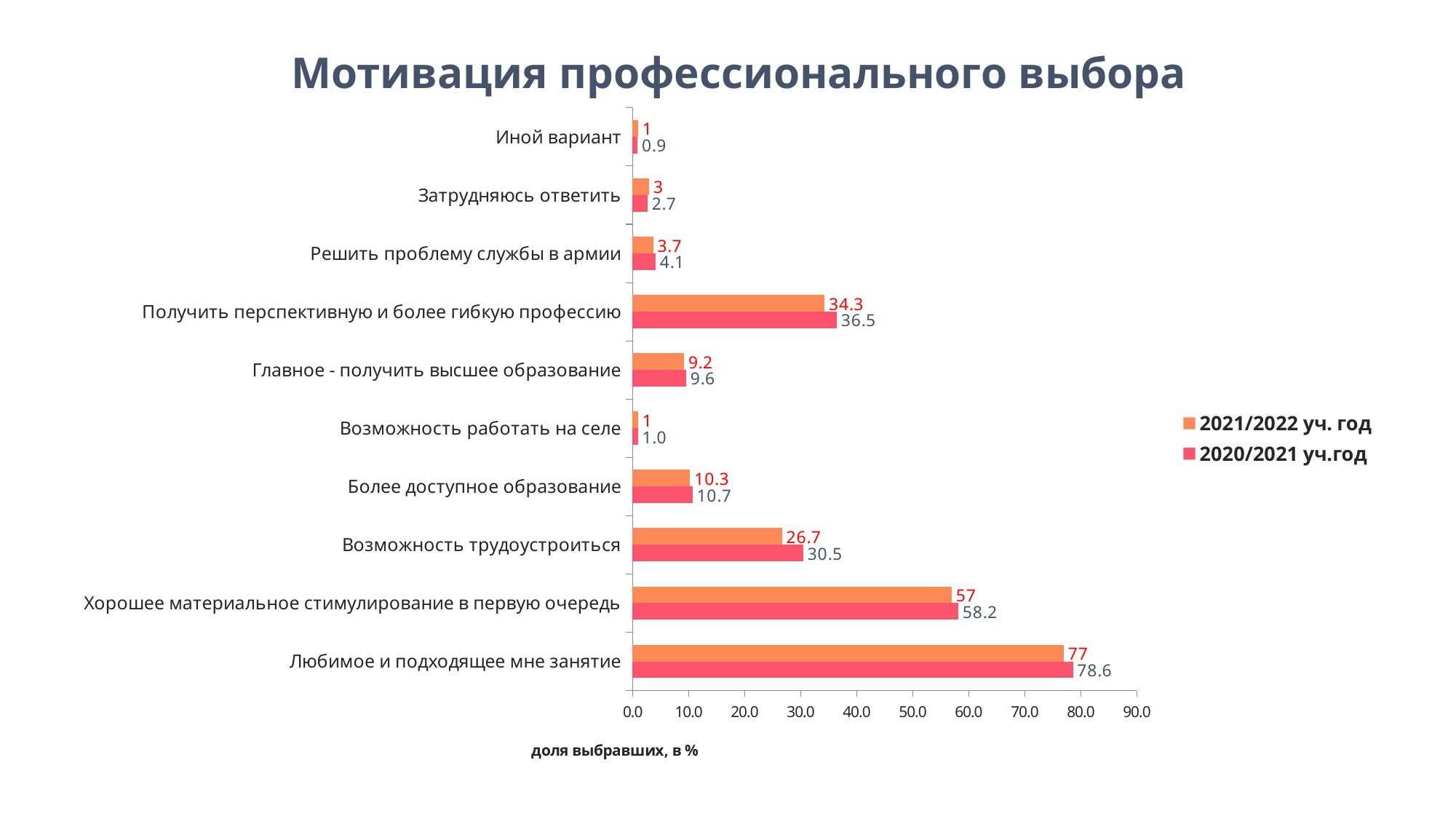
What is the value for "Любимое и подходящее мне занятие" in the 2020/2021 уч.год series? 78.6 For "Решить проблему службы в армии", which series has the larger value: 2021/2022 уч. год or 2020/2021 уч.год? 2020/2021 уч.год What type of chart is shown on the slide? Bar chart Which category has the lowest value in the 2020/2021 уч.год series? Иной вариант How many series does the legend list? 2 What is the x-axis label of the chart? доля выбравших, в % What is the title of the chart? Мотивация профессионального выбора How many categories are shown on the chart? 10 What is the value for "Хорошее материальное стимулирование в первую очередь" in the 2021/2022 уч. год series? 57 What is the value for "Получить перспективную и более гибкую профессию" in the 2020/2021 уч.год series? 36.5 Which category has the highest value in the 2021/2022 уч. год series? Любимое и подходящее мне занятие What is the difference between the 2020/2021 уч.год and 2021/2022 уч. год values for "Возможность трудоустроиться"? 3.8